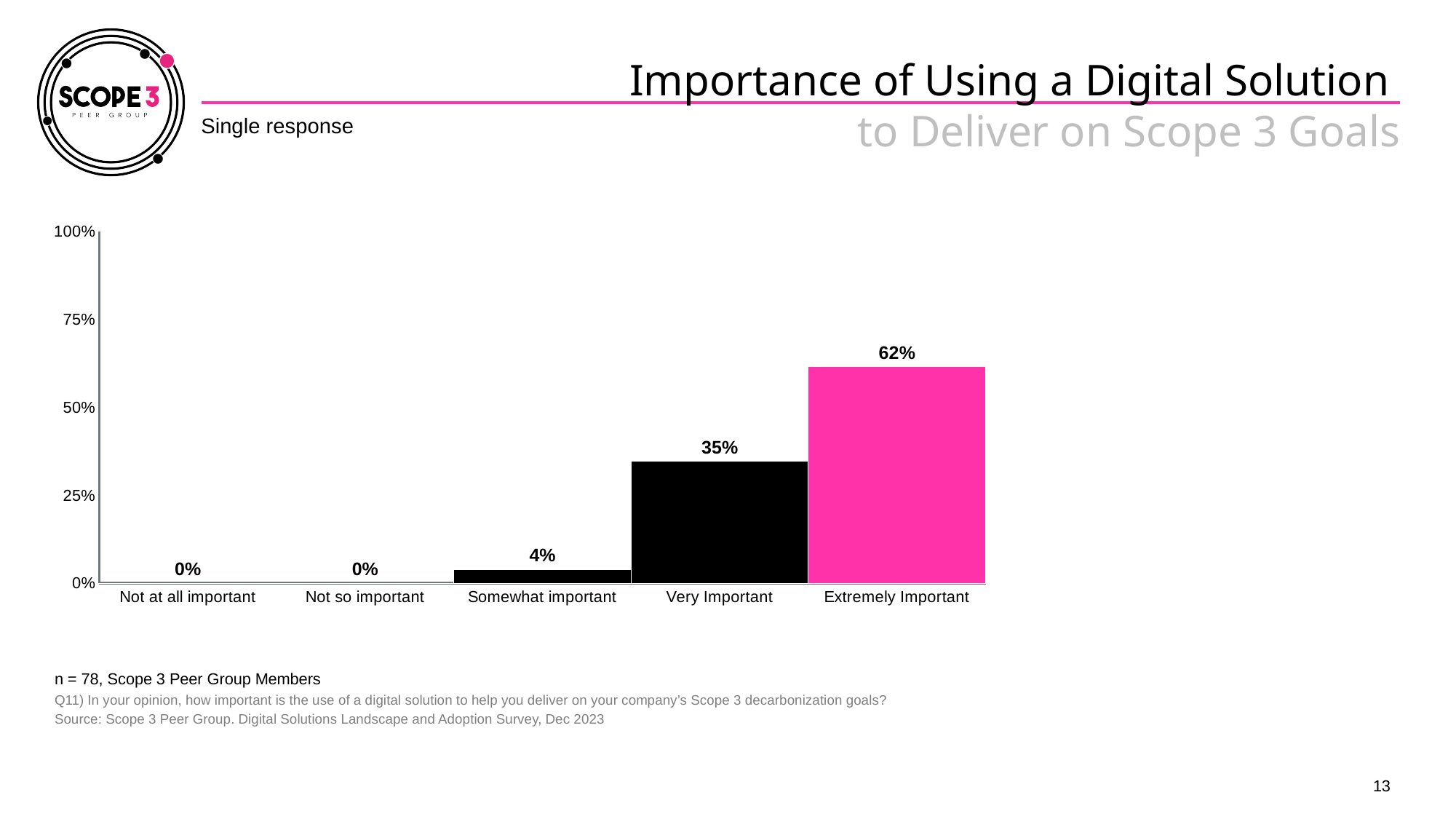
What is the value shown for Not so important? 0% Is the value for Extremely Important greater or less than 50%? greater What is the difference between the Very Important and Somewhat important values? 31% What is the value shown for Somewhat important? 4% Which is larger, the value for Very Important or the value for Somewhat important? Very Important How many categories are shown on the x axis? 5 What kind of chart is shown on the slide? bar chart What is the difference between the Extremely Important and Very Important values? 27% What is the value shown for Very Important? 35% What colour is the bar for Extremely Important? pink Which category has the highest value? Extremely Important What percentage of respondents rated using a digital solution as Extremely Important? 62%